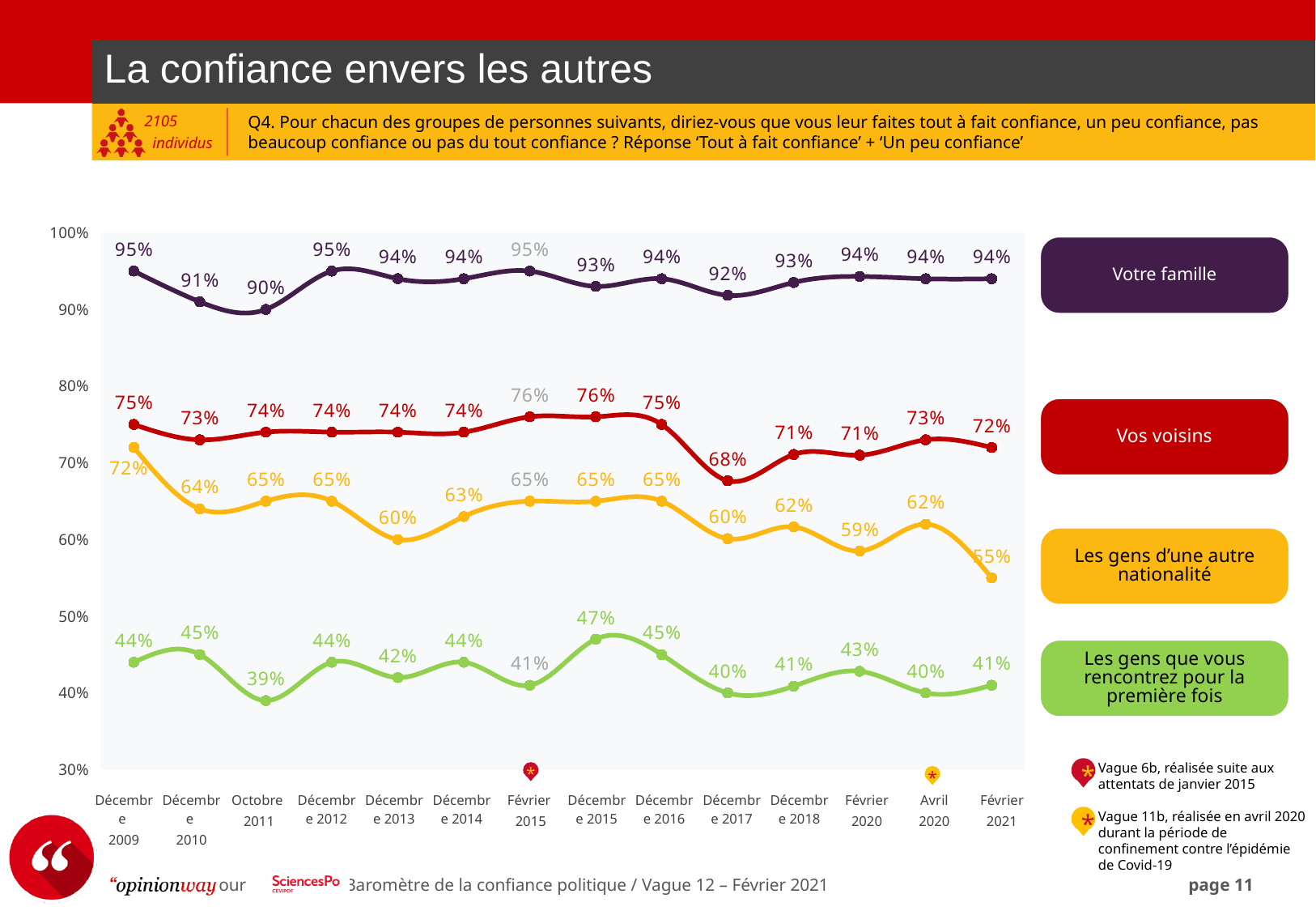
How many time points are plotted on the x axis? 14 What is the value for 'Les gens que vous rencontrez pour la première fois' in Décembre 2015? 47% In which period does 'Les gens que vous rencontrez pour la première fois' reach its lowest value? Octobre 2011 What is the difference between 'Vos voisins' and 'Les gens d'une autre nationalité' in Février 2021? 17 percentage points Which is larger in Avril 2020: 'Vos voisins' or 'Les gens d'une autre nationalité'? Vos voisins What type of chart is shown on the slide? line chart What is the value for 'Les gens d'une autre nationalité' in Février 2021? 55% How many series are shown in the chart? 4 Between Avril 2020 and Février 2021, does the value for 'Les gens d'une autre nationalité' rise or fall? fall What is the value for 'Vos voisins' in Décembre 2017? 68% What is the value for 'Votre famille' in Février 2021? 94% In which period does 'Les gens d'une autre nationalité' reach its highest value? Décembre 2009